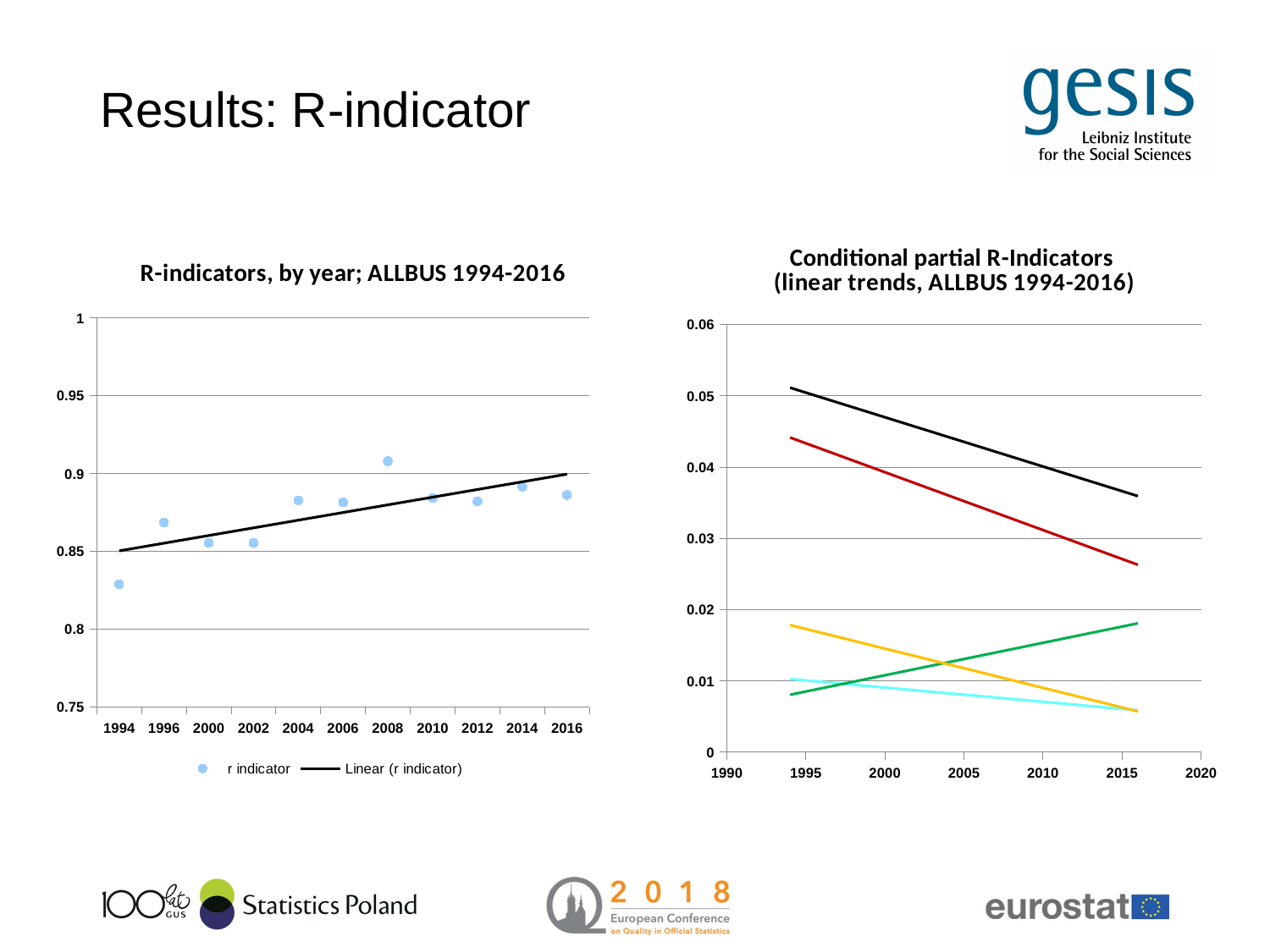
In the left chart 'R-indicators, by year; ALLBUS 1994-2016', does the linear trend line rise or fall from 1994 to 2016? rise In the left chart 'R-indicators, by year; ALLBUS 1994-2016', how many data points are plotted? 11 In the right chart 'Conditional partial R-Indicators (linear trends, ALLBUS 1994-2016)', does the green line rise or fall over time? rise How many lines are plotted in the right chart 'Conditional partial R-Indicators (linear trends, ALLBUS 1994-2016)'? 5 In the left chart 'R-indicators, by year; ALLBUS 1994-2016', is the r indicator for 2008 greater or less than 0.9? greater What kind of chart is the left chart, 'R-indicators, by year; ALLBUS 1994-2016'? scatter chart with a linear trend line In the right chart 'Conditional partial R-Indicators (linear trends, ALLBUS 1994-2016)', is the value of the black line at 1994 greater or less than 0.05? greater In the left chart 'R-indicators, by year; ALLBUS 1994-2016', which year has the highest r indicator? 2008 In the left chart 'R-indicators, by year; ALLBUS 1994-2016', which year has the lowest r indicator? 1994 In the left chart 'R-indicators, by year; ALLBUS 1994-2016', is the r indicator for 1994 greater or less than 0.85? less In the right chart 'Conditional partial R-Indicators (linear trends, ALLBUS 1994-2016)', which line is higher at 2016, the black line or the red line? the black line How many entries does the legend of the left chart 'R-indicators, by year; ALLBUS 1994-2016' list? 2